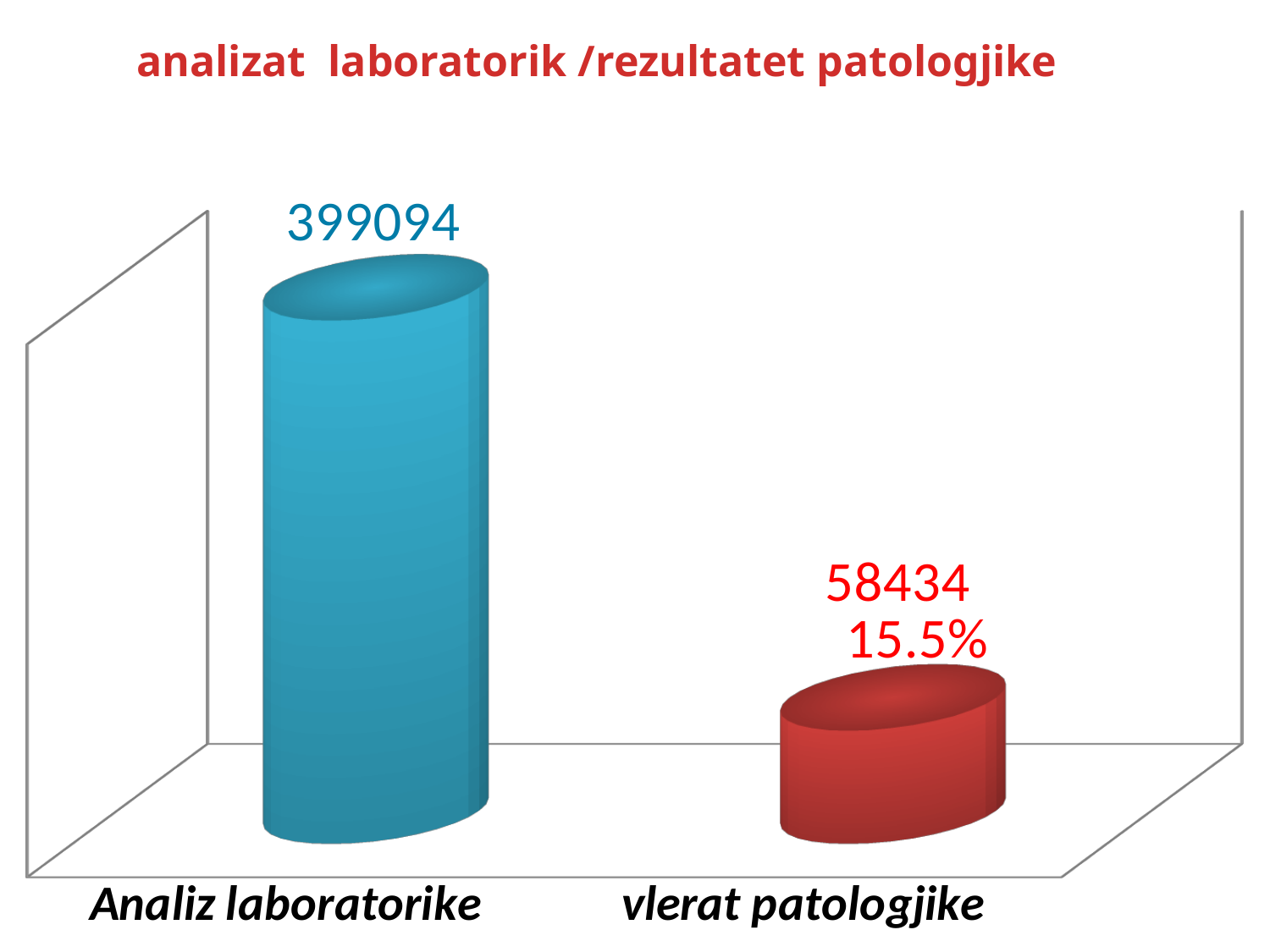
How many categories are shown in the chart? 2 What percentage is shown above the vlerat patologjike bar? 15.5% Which category has the highest value? Analiz laboratorike What is the title of the chart? analizat laboratorik /rezultatet patologjike What is the value for Analiz laboratorike? 399094 What is the difference between the values for Analiz laboratorike and vlerat patologjike? 340660 What is the value for vlerat patologjike? 58434 Which category has the lowest value? vlerat patologjike What colour is the bar for vlerat patologjike? red What kind of chart is shown on the slide? bar chart Which is larger, the value for Analiz laboratorike or the value for vlerat patologjike? Analiz laboratorike